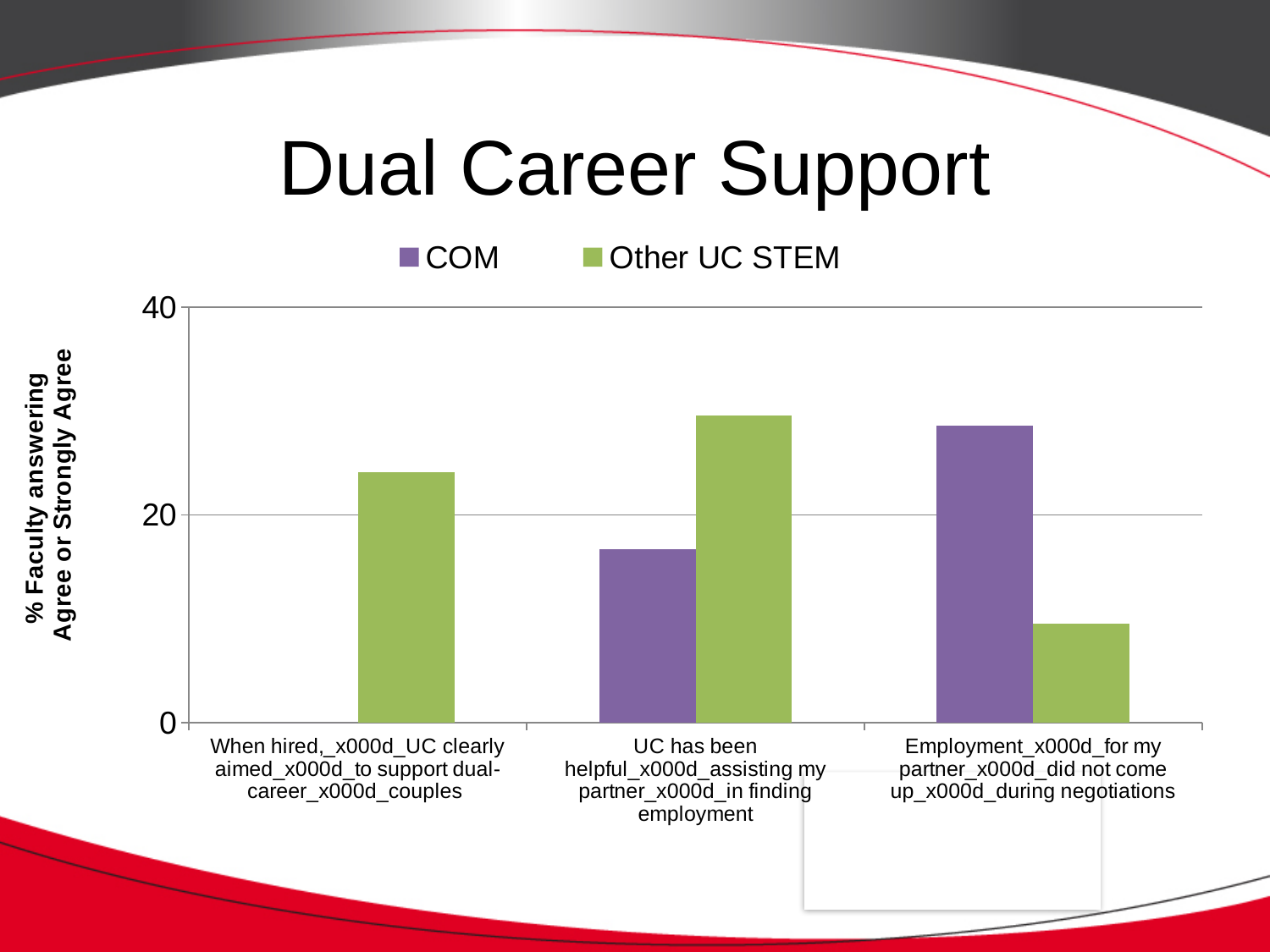
For "Employment for my partner did not come up during negotiations", which series has the larger value, COM or Other UC STEM? COM Which category has the highest Other UC STEM value? UC has been helpful assisting my partner in finding employment Is the Other UC STEM value for "UC has been helpful assisting my partner in finding employment" greater or less than 20? greater How many categories are shown on the x axis? 3 How many series does the legend list? 2 Is the COM value for "UC has been helpful assisting my partner in finding employment" greater or less than 20? less Is the COM value for "Employment for my partner did not come up during negotiations" greater or less than 20? greater For "UC has been helpful assisting my partner in finding employment", which series has the larger value, COM or Other UC STEM? Other UC STEM Which category has the highest COM value? Employment for my partner did not come up during negotiations What kind of chart is shown on the slide? bar chart